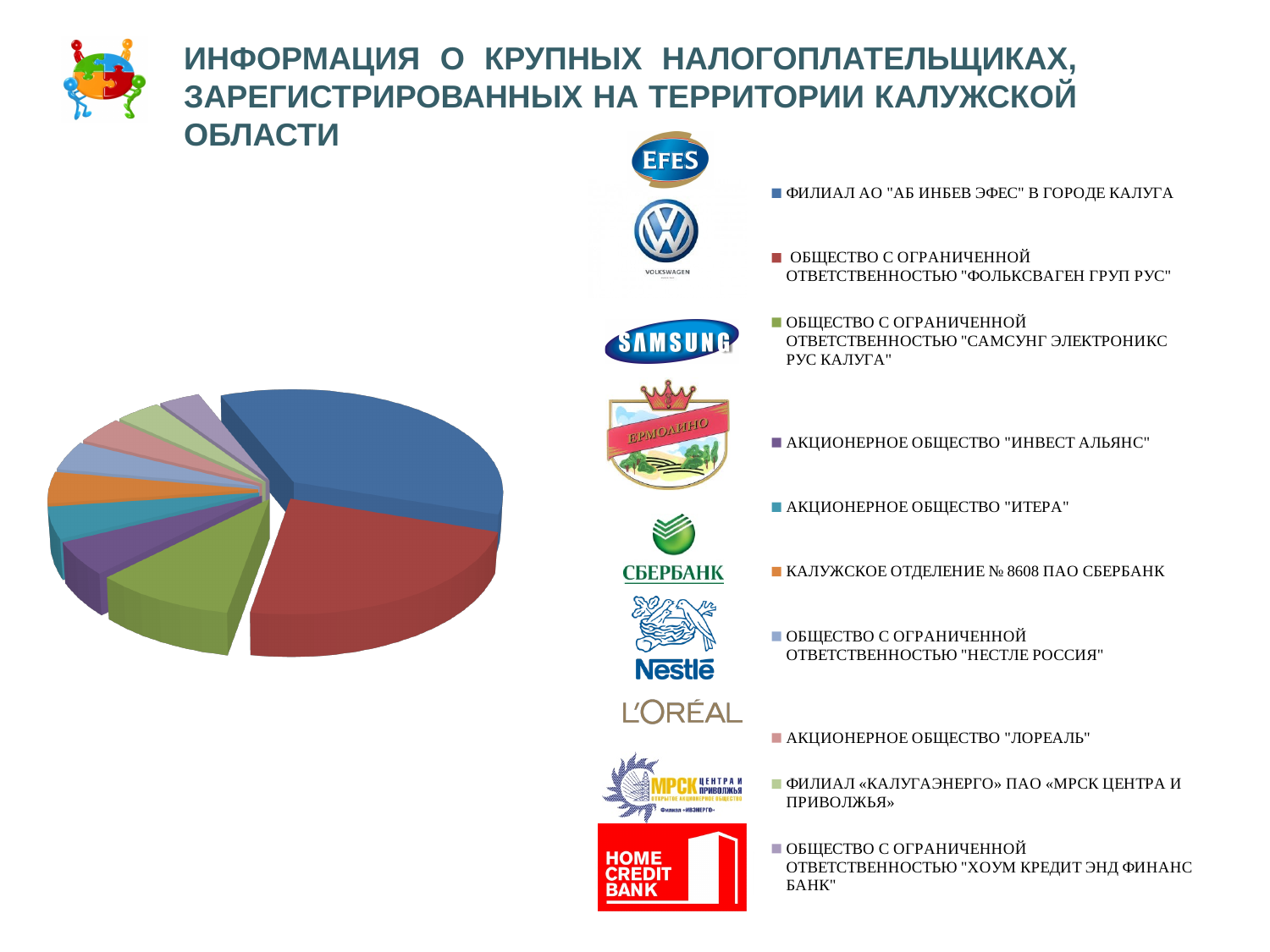
How many entries does the legend of the pie chart list? 10 What kind of chart is shown on the slide? pie chart Which colour represents ФИЛИАЛ АО "АБ ИНБЕВ ЭФЕС" В ГОРОДЕ КАЛУГА in the pie chart? blue Which slice is larger: ОБЩЕСТВО С ОГРАНИЧЕННОЙ ОТВЕТСТВЕННОСТЬЮ "САМСУНГ ЭЛЕКТРОНИКС РУС КАЛУГА" or АКЦИОНЕРНОЕ ОБЩЕСТВО "ИНВЕСТ АЛЬЯНС"? ОБЩЕСТВО С ОГРАНИЧЕННОЙ ОТВЕТСТВЕННОСТЬЮ "САМСУНГ ЭЛЕКТРОНИКС РУС КАЛУГА" Which category has the largest slice in the pie chart? ФИЛИАЛ АО "АБ ИНБЕВ ЭФЕС" В ГОРОДЕ КАЛУГА Which slice is larger: ОБЩЕСТВО С ОГРАНИЧЕННОЙ ОТВЕТСТВЕННОСТЬЮ "ФОЛЬКСВАГЕН ГРУП РУС" or ОБЩЕСТВО С ОГРАНИЧЕННОЙ ОТВЕТСТВЕННОСТЬЮ "САМСУНГ ЭЛЕКТРОНИКС РУС КАЛУГА"? ОБЩЕСТВО С ОГРАНИЧЕННОЙ ОТВЕТСТВЕННОСТЬЮ "ФОЛЬКСВАГЕН ГРУП РУС" Which legend entry is shown in green in the pie chart? ОБЩЕСТВО С ОГРАНИЧЕННОЙ ОТВЕТСТВЕННОСТЬЮ "САМСУНГ ЭЛЕКТРОНИКС РУС КАЛУГА" Which slice is larger: ФИЛИАЛ АО "АБ ИНБЕВ ЭФЕС" В ГОРОДЕ КАЛУГА or ОБЩЕСТВО С ОГРАНИЧЕННОЙ ОТВЕТСТВЕННОСТЬЮ "ФОЛЬКСВАГЕН ГРУП РУС"? ФИЛИАЛ АО "АБ ИНБЕВ ЭФЕС" В ГОРОДЕ КАЛУГА How many slices (categories) does the pie chart have? 10